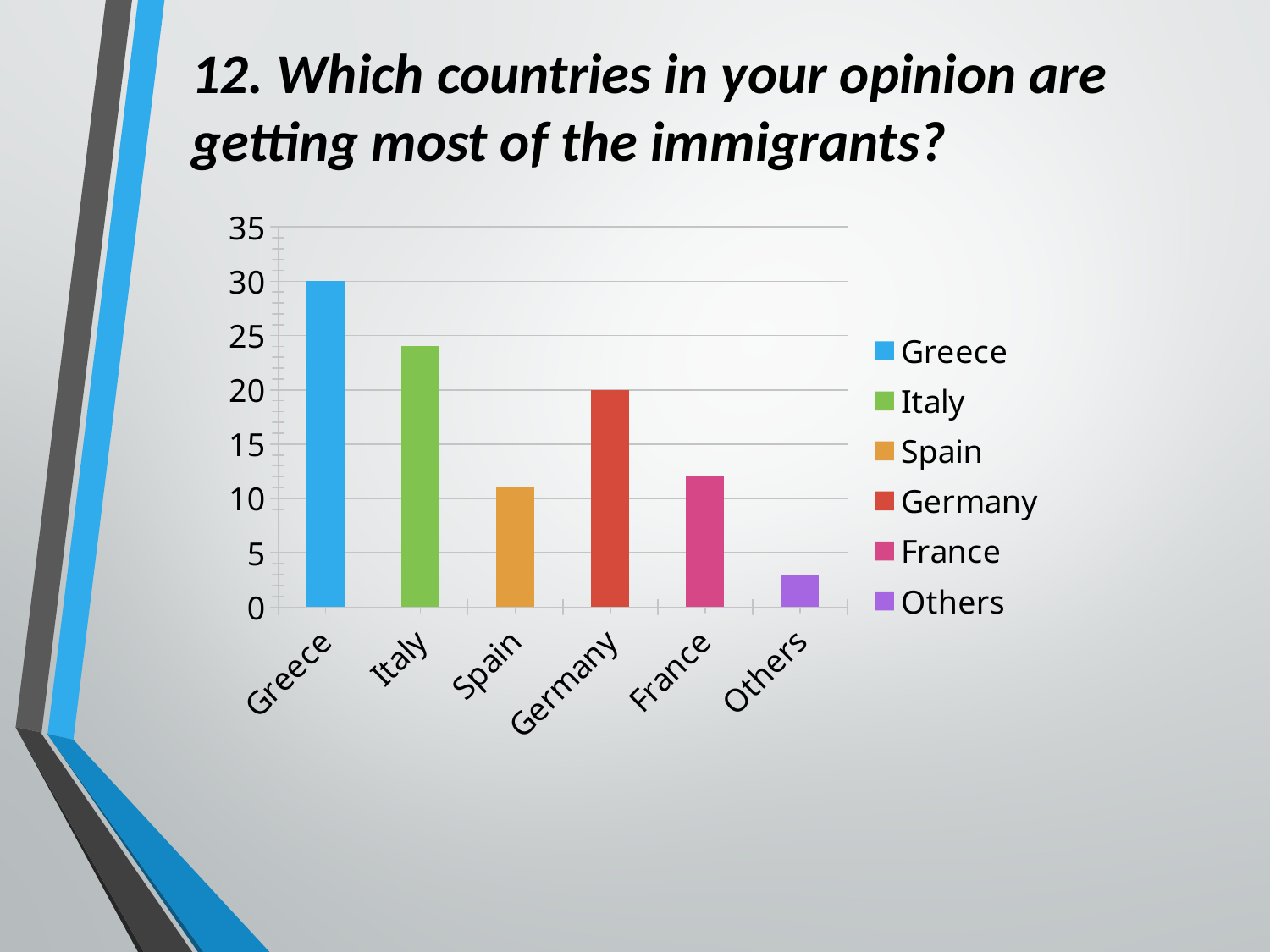
Is the value for Spain greater or less than 15? less Is the value for France greater or less than 10? greater Which has a larger value, Germany or Spain? Germany Is the value for Italy greater or less than 25? less Which country has the highest bar in the chart? Greece Which category has the lowest bar in the chart? Others How many categories are shown on the x axis of the chart? 6 How many entries does the chart's legend list? 6 Which has a larger value, Italy or Germany? Italy What kind of chart is shown on the slide? Bar chart